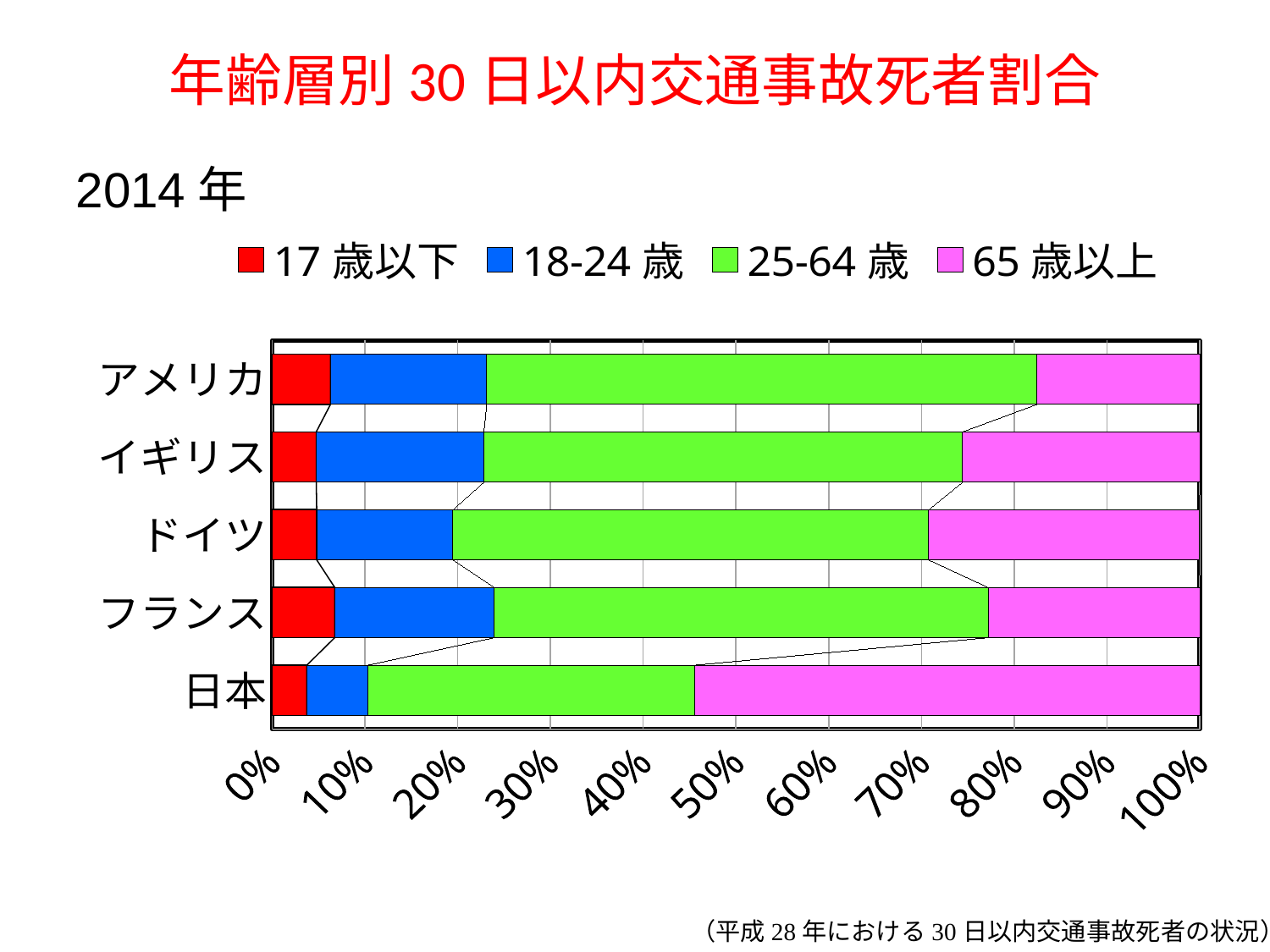
Is the 65歳以上 share for アメリカ greater or less than 20%? less How many age-group series does the legend list? 4 Which country has the largest share for 65歳以上? 日本 Which year does the chart cover? 2014年 Which is larger: the 65歳以上 share for 日本 or for アメリカ? 日本 Which colour represents the 65歳以上 age group? Pink (magenta) Is the 18-24歳 share for 日本 greater or less than 10%? less What kind of chart is shown on the slide? Stacked bar chart How many countries are shown on the chart? 5 Which country has the largest share for 25-64歳? アメリカ Which country has the smallest share for 25-64歳? 日本 Is the 65歳以上 share for 日本 greater or less than 50%? greater